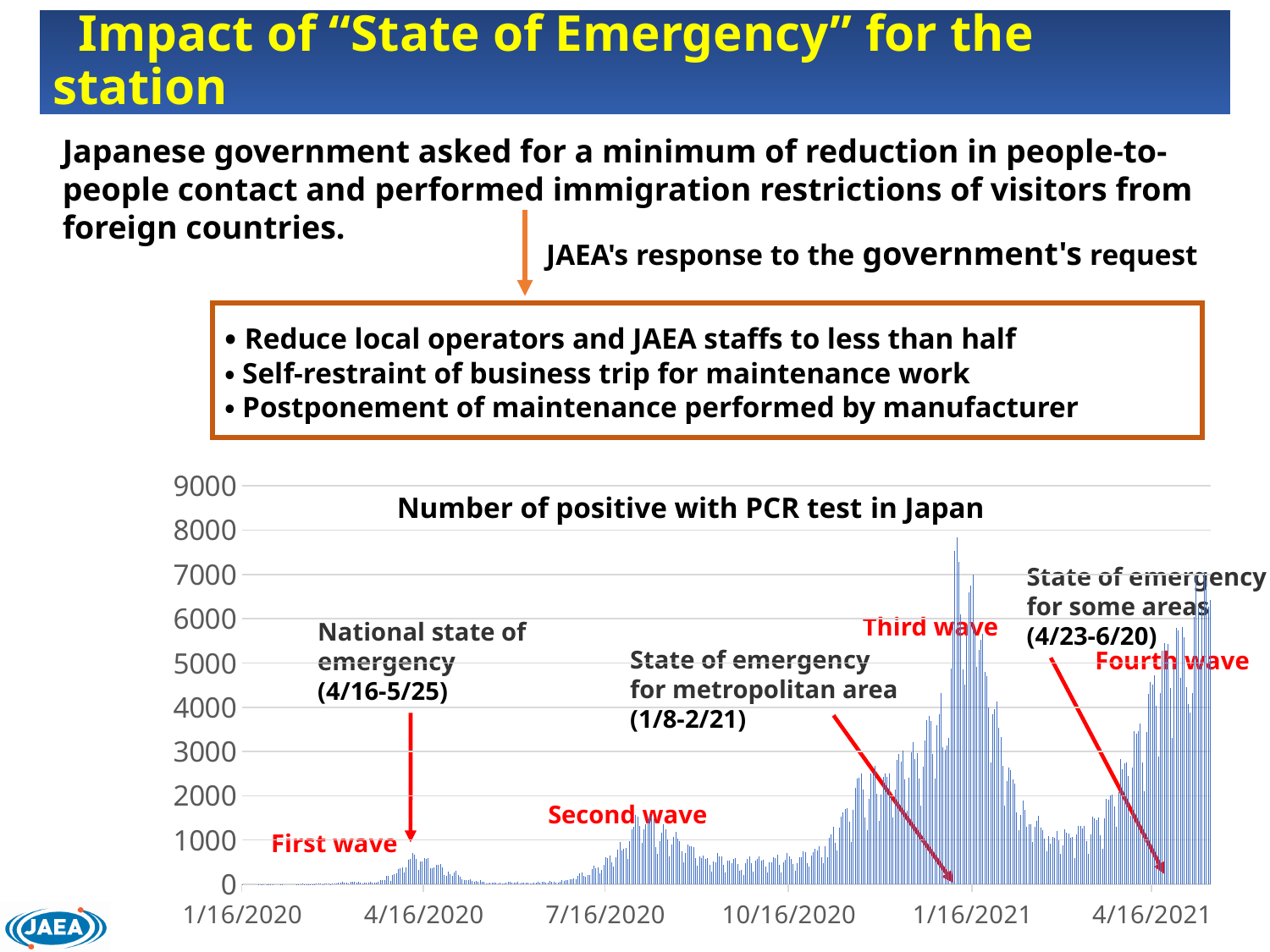
Is the peak of the second wave greater or less than 1000? greater Is the peak of the first wave greater or less than 1000? less What is the title of the chart? Number of positive with PCR test in Japan Is the peak of the fourth wave greater or less than 5000? greater Which has a higher peak, the third wave or the second wave? Third wave What kind of chart is shown on the slide? bar chart What date range is given for the national state of emergency annotated on the chart? 4/16-5/25 Which labeled wave has the lowest peak in the chart? First wave Which labeled wave reaches the highest peak in the chart? Third wave How many waves are labeled on the chart? 4 Which has a higher peak, the second wave or the first wave? Second wave